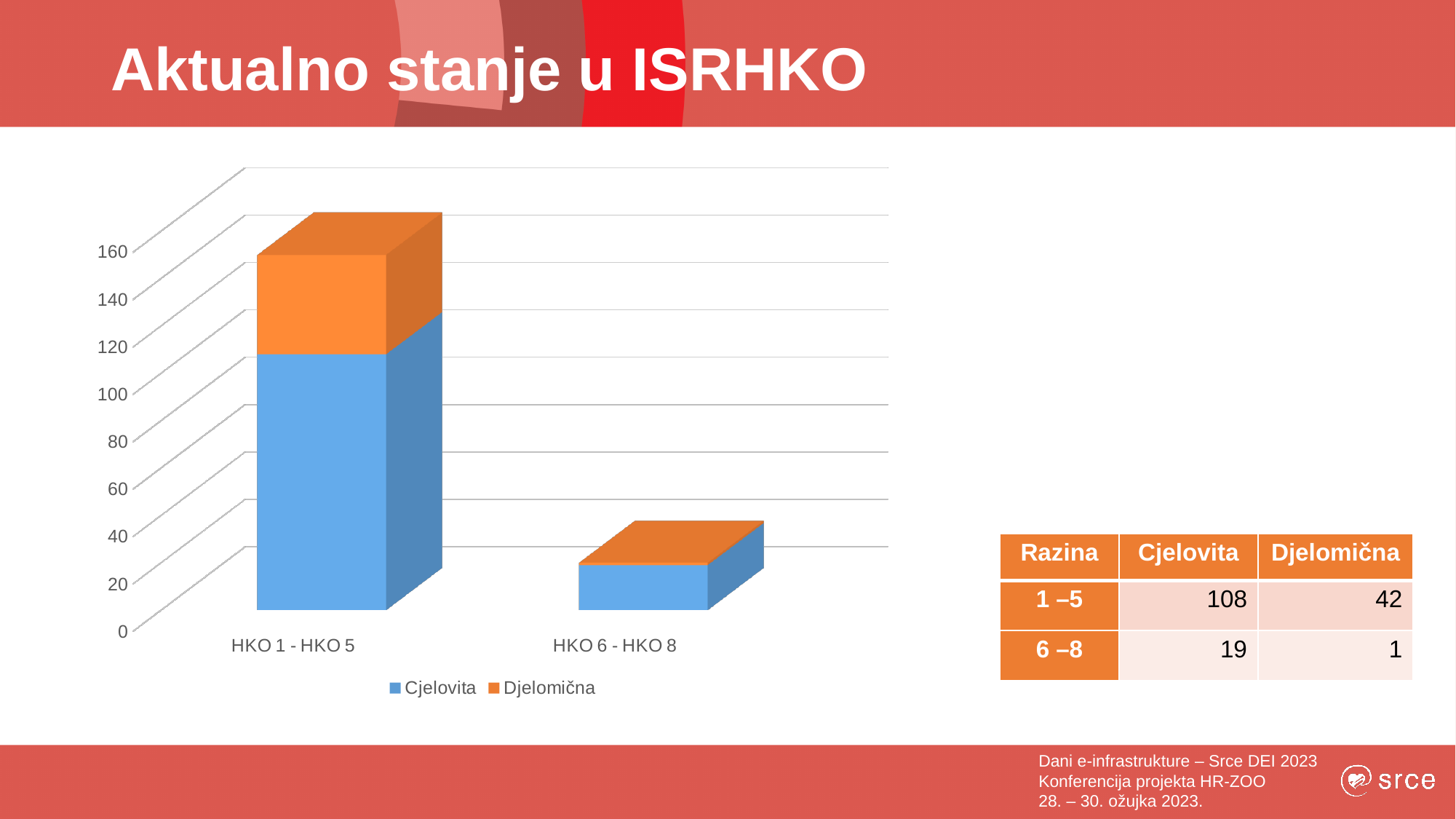
According to the table on the slide, what is the Djelomična value for level 6–8? 1 Which colour represents the Djelomična series in the chart? Orange Is the Cjelovita value for HKO 1 - HKO 5 greater or less than 80? greater Which category has the highest total stacked bar? HKO 1 - HKO 5 Is the total stacked value for HKO 6 - HKO 8 greater or less than 40? less What kind of chart is shown on the slide? Stacked bar chart How many series does the chart legend list? 2 Using the values in the table, what is the difference between the Cjelovita values for level 1–5 and level 6–8? 89 Using the values in the table, what is the total of the stacked bar for HKO 1 - HKO 5 (Cjelovita plus Djelomična)? 150 How many categories are shown on the x axis of the chart? 2 According to the table on the slide, what is the Cjelovita value for level 1–5? 108 Which category has the lowest total stacked bar? HKO 6 - HKO 8